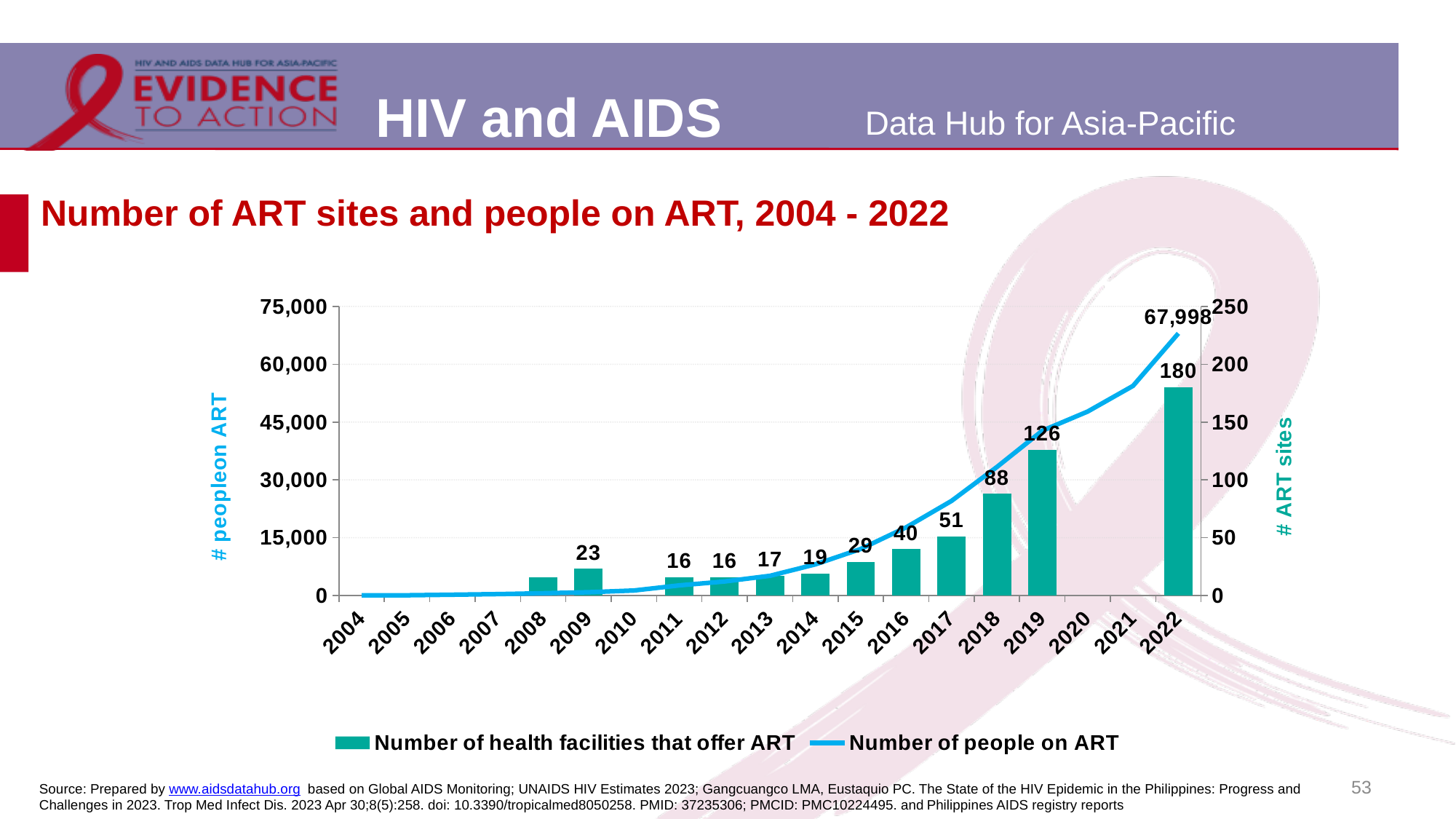
What is the difference in the number of ART sites between 2018 and 2017? 37 How many series does the legend list? 2 Which year had more health facilities offering ART, 2014 or 2016? 2016 By how much did the number of health facilities that offer ART increase from 2019 to 2022? 54 What was the number of health facilities that offer ART in 2019? 126 How many health facilities offered ART in 2015? 29 In which year was the number of health facilities that offer ART highest? 2022 How many health facilities offered ART in 2022? 180 What was the number of people on ART in 2022? 67,998 How many years are shown on the x axis? 19 Is the number of people on ART in 2021 greater or less than 45,000? greater What kind of chart is shown on the slide? Combined bar and line chart